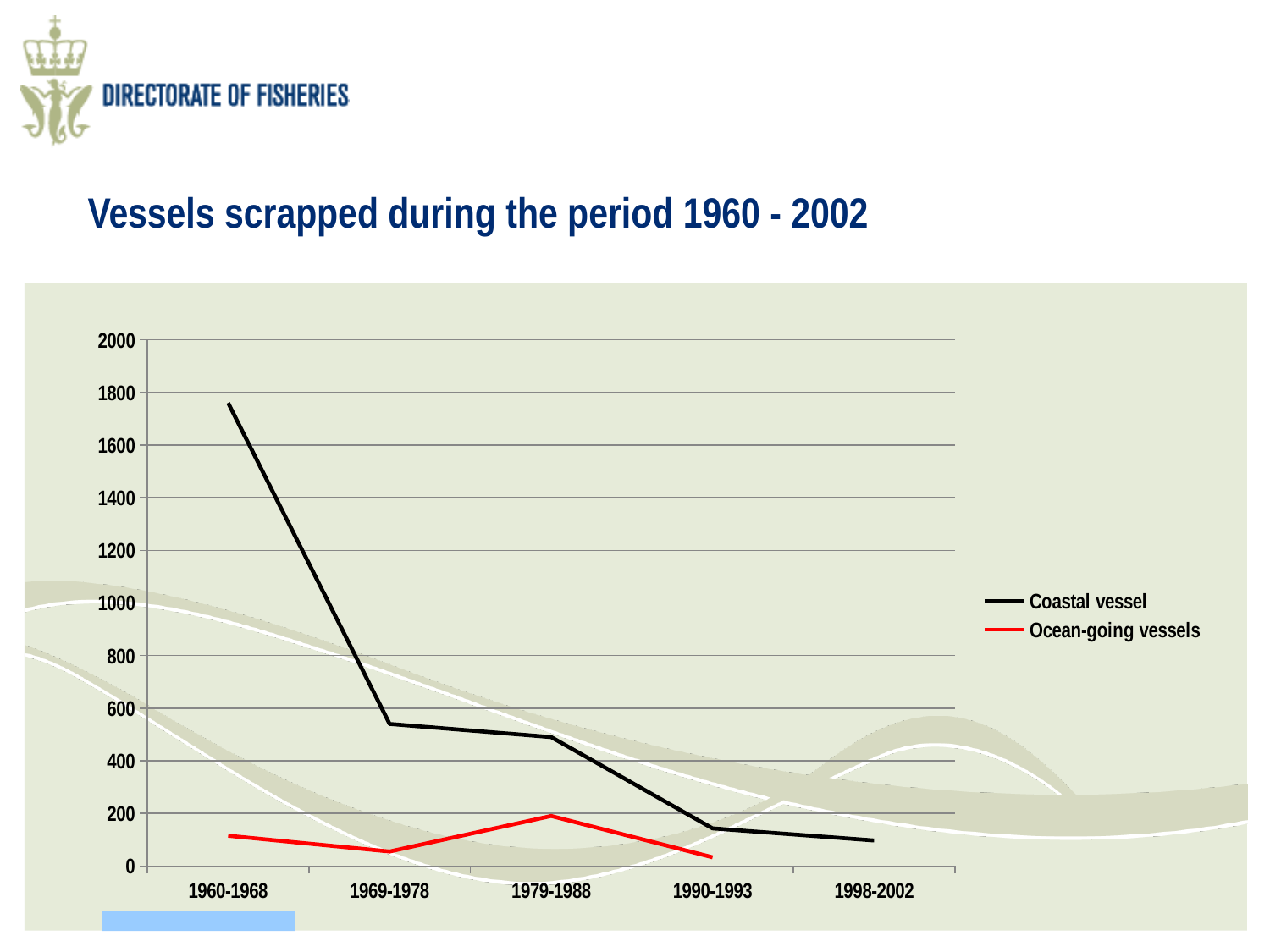
In which period is the Ocean-going vessels value highest? 1979-1988 In which period is the Coastal vessel value highest? 1960-1968 Is the Coastal vessel value for 1969-1978 greater or less than 600? less What is the title of the chart? Vessels scrapped during the period 1960 - 2002 Is the Coastal vessel value for 1960-1968 greater or less than 1600? greater Which series has the larger value in 1969-1978, Coastal vessel or Ocean-going vessels? Coastal vessel Is the Ocean-going vessels value for 1979-1988 greater or less than 400? less How many series does the legend list? 2 In which period is the Coastal vessel value lowest? 1998-2002 What kind of chart is shown on the slide? line chart Does the Coastal vessel line rise or fall from 1960-1968 to 1998-2002? fall How many periods are shown on the x axis? 5